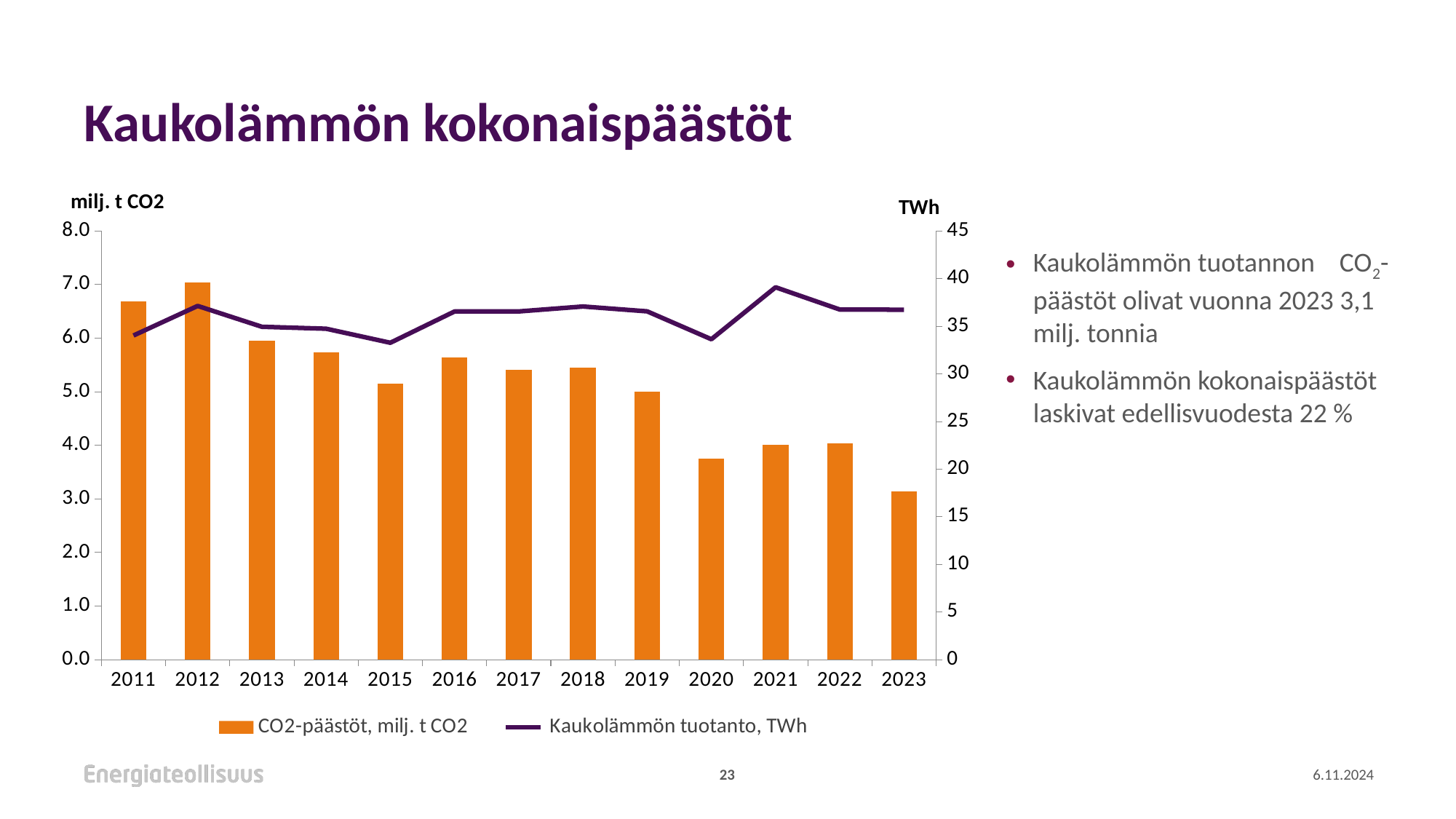
How many years are shown on the x axis of the chart? 13 In which year is the CO2-päästöt bar the lowest? 2023 In which year does the Kaukolämmön tuotanto, TWh line reach its highest point? 2021 What kind of chart is shown on the slide? A combined bar and line chart How many series does the chart legend list? 2 In which year is the CO2-päästöt bar the highest? 2012 Is the Kaukolämmön tuotanto value for 2021 greater or less than 35 TWh? greater Which year has a higher CO2-päästöt bar, 2011 or 2019? 2011 Is the CO2-päästöt value for 2020 greater or less than 4.0 milj. t CO2? less Do the CO2-päästöt bars generally rise or fall from 2011 to 2023? fall What unit label is shown above the right-hand axis of the chart? TWh